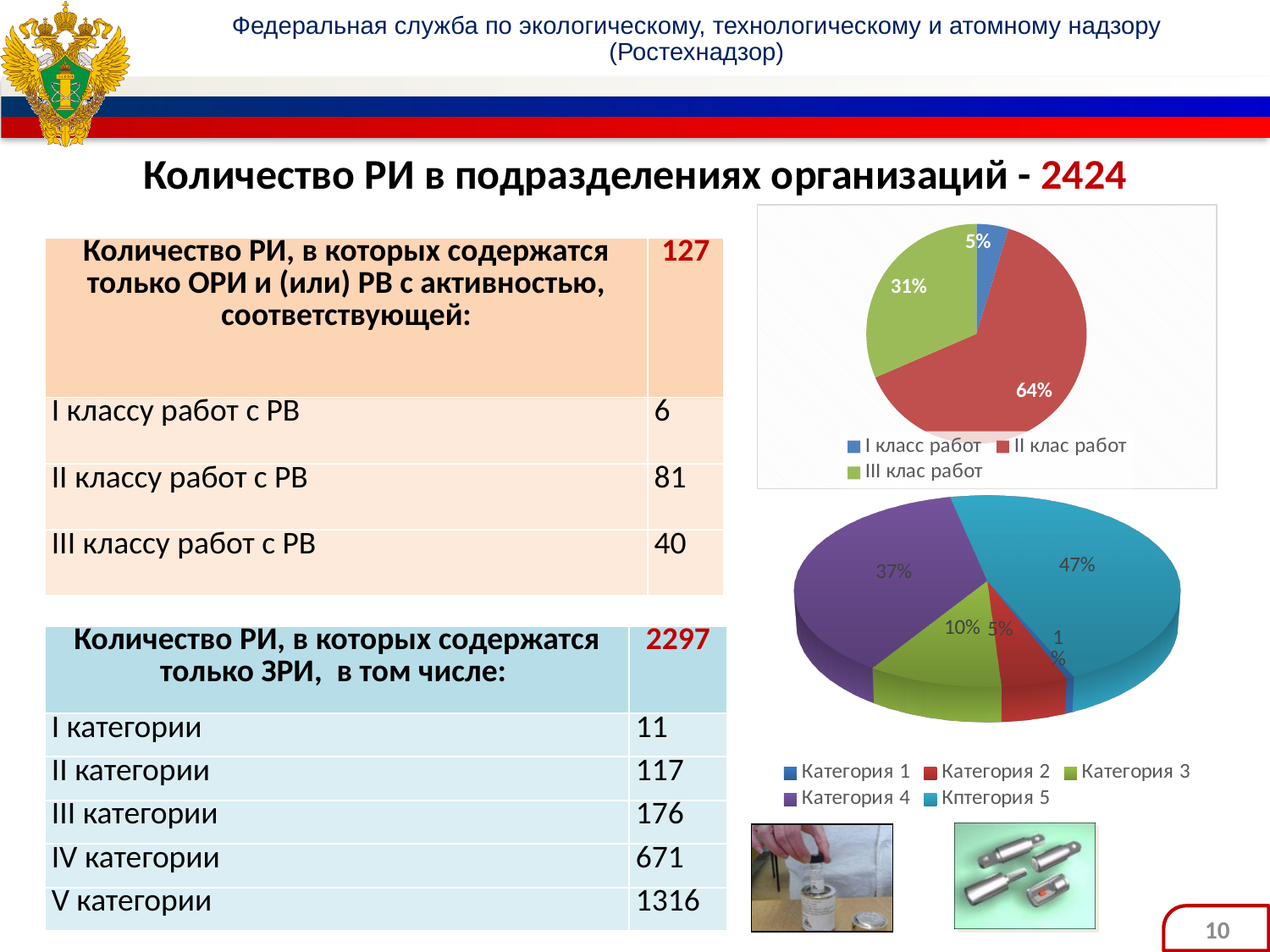
In the bottom pie chart, what is the difference in percentage points between "Кптегория 5" and "Категория 4"? 10 How many categories does the legend of the bottom pie chart list? 5 In the bottom pie chart, which category has the smallest share? Категория 1 In the bottom pie chart, what share does "Категория 3" have? 10% In the bottom pie chart, which category has the largest share? Кптегория 5 In the top pie chart, which class has the smallest share? I класс работ How many entries does the legend of the top pie chart list? 3 In the top pie chart, which class has the largest share? II клас работ In the top pie chart, what share does "III клас работ" have? 31% In the bottom pie chart, what share does "Категория 4" have? 37% What kind of chart is the top chart on the right of the slide? pie chart